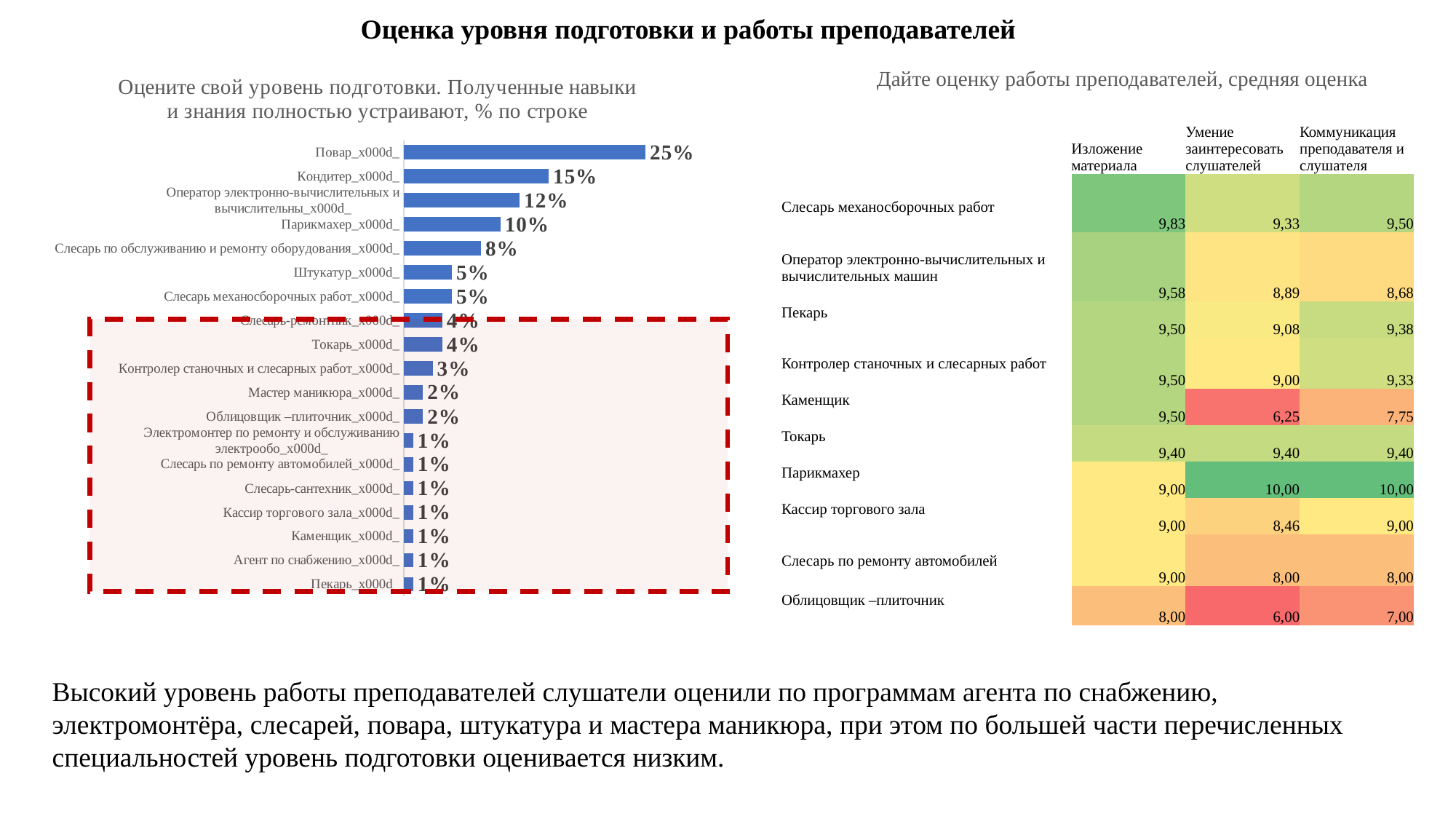
On the left bar chart, what is the value for Слесарь по обслуживанию и ремонту оборудования? 8% On the left bar chart, what is the value for Повар? 25% In the right-hand table, what is the Изложение материала score for Слесарь механосборочных работ? 9,83 On the left bar chart, how many categories are shown? 19 On the left bar chart, what is the difference between the values for Повар and Кондитер? 10% On the left bar chart, which is larger: the value for Штукатур or the value for Токарь? Штукатур What kind of chart is shown on the left of the slide? Bar chart On the left bar chart, what is the value for Парикмахер? 10% On the left bar chart, which category has the highest value? Повар In the right-hand table, which profession has the lowest Умение заинтересовать слушателей score? Облицовщик –плиточник On the left bar chart, what is the value for Кондитер? 15% What is the title of the left bar chart? Оцените свой уровень подготовки. Полученные навыки и знания полностью устраивают, % по строке